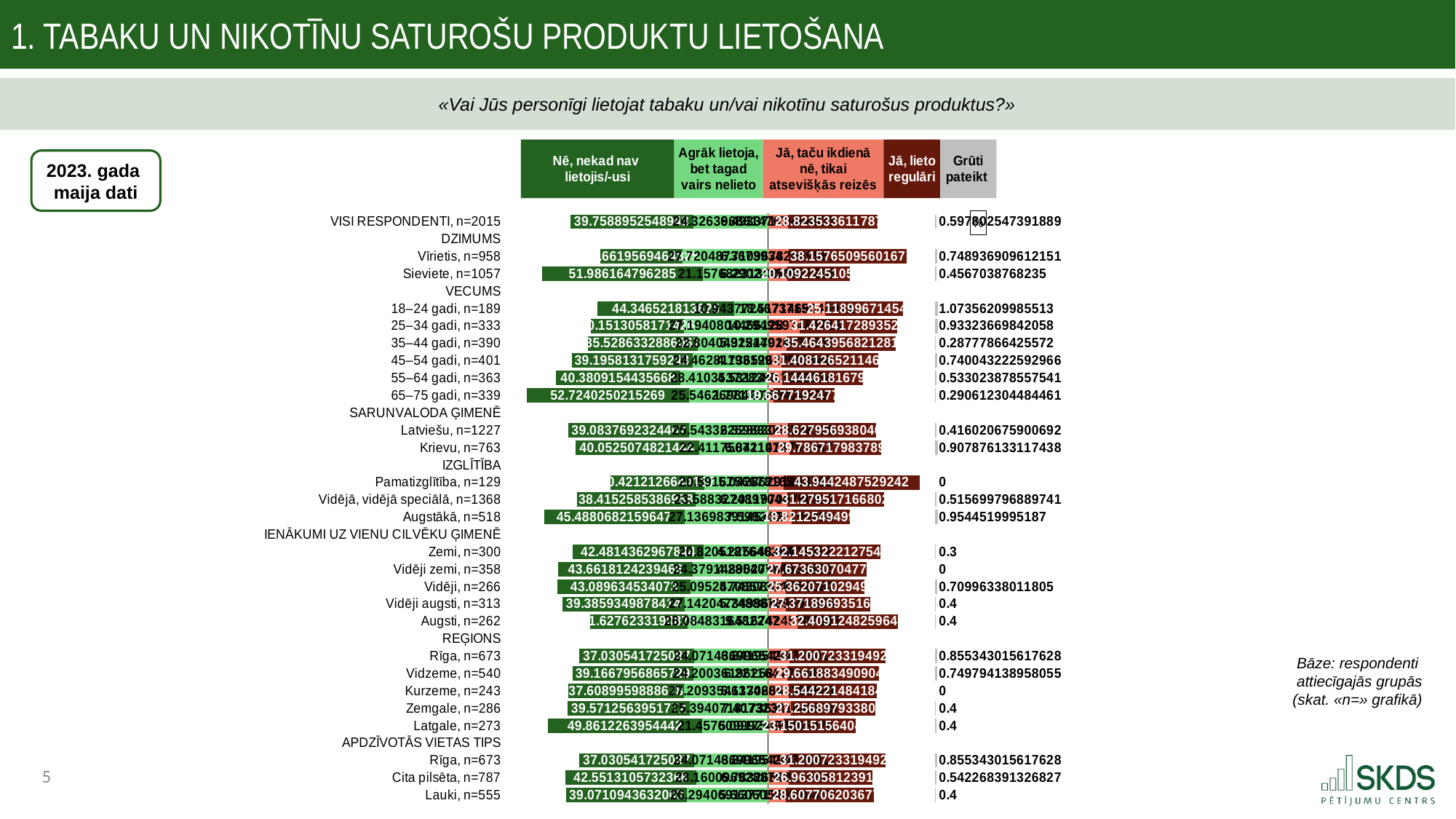
What is the 'Grūti pateikt' value for 'Latgale, n=273'? 0.4 How many regions are listed under the REĢIONS section of the chart? 5 What is the 'Nē, nekad nav lietojis/-usi' value for 'Sieviete, n=1057'? 51.986164796285 What is the 'Grūti pateikt' value for 'Pamatizglītība, n=129'? 0 Which has the larger 'Grūti pateikt' value, 'Latviešu, n=1227' or 'Krievu, n=763'? Krievu, n=763 What is the 'Grūti pateikt' value for '18–24 gadi, n=189'? 1.07356209985513 Among the VECUMS (age) groups, which has the highest 'Nē, nekad nav lietojis/-usi' value? 65–75 gadi, n=339 How many series does the legend at the top of the chart list? 5 What is the 'Nē, nekad nav lietojis/-usi' value for '65–75 gadi, n=339'? 52.7240250215269 What is the 'Grūti pateikt' value for 'Vīrietis, n=958'? 0.748936909612151 What kind of chart is shown on the slide? bar chart Which has the larger 'Nē, nekad nav lietojis/-usi' value, 'Vīrietis, n=958' or 'Sieviete, n=1057'? Sieviete, n=1057